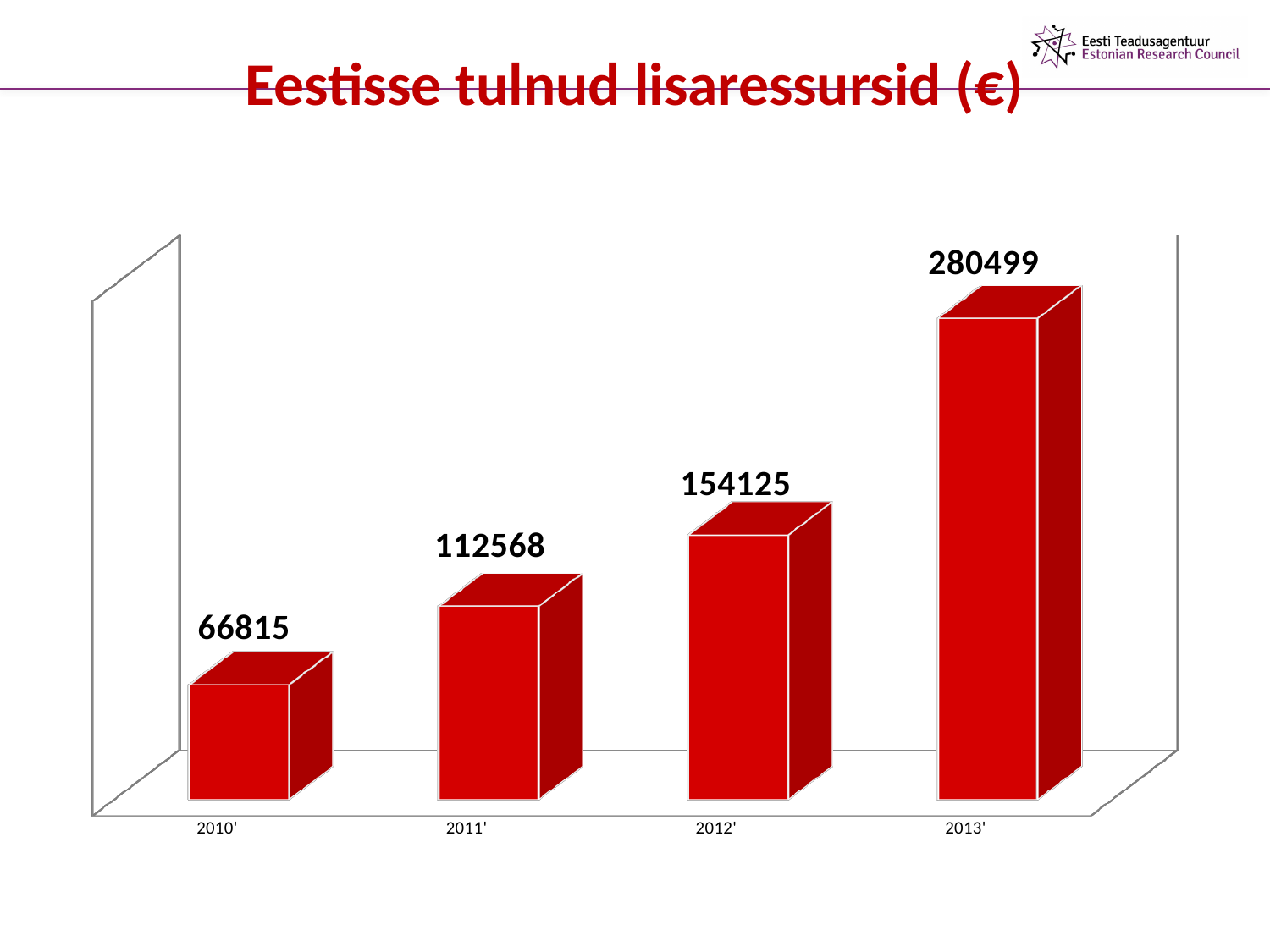
What kind of chart is shown on the slide? bar chart Which year has the lowest value? 2010' What is the value for 2013'? 280499 Which year has the highest value? 2013' How many years are shown on the chart? 4 What is the difference between the values for 2013' and 2012'? 126374 What is the difference between the values for 2011' and 2010'? 45753 What is the value for 2010'? 66815 Which is larger, the value for 2011' or the value for 2012'? 2012' What is the value for 2011'? 112568 What is the value for 2012'? 154125 Do the values rise or fall from 2010' to 2013'? rise